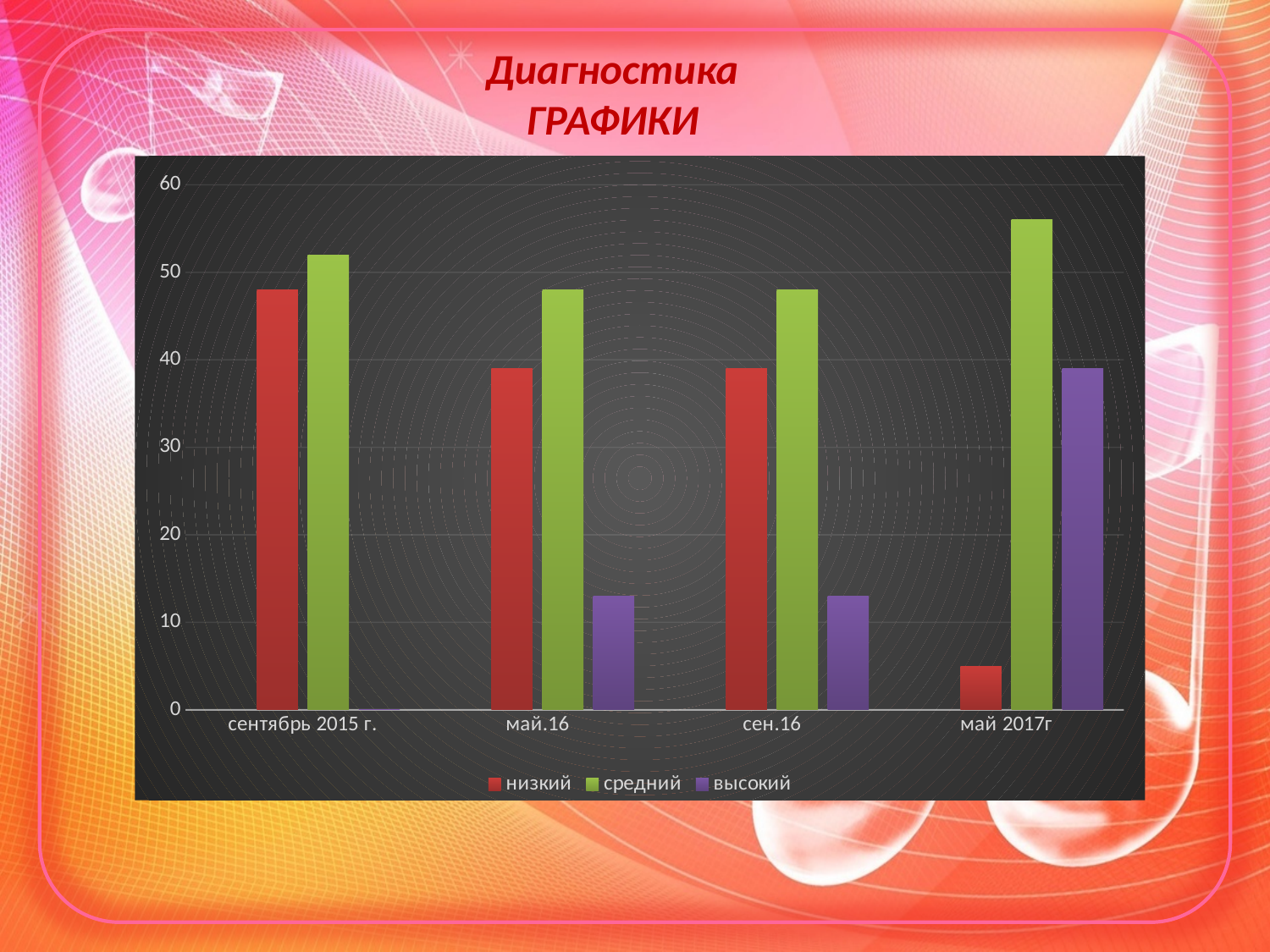
Is the value for низкий in сентябрь 2015 г. greater or less than 40? greater Is the value for низкий in май 2017г greater or less than 10? less Is the value for средний in май 2017г greater or less than 50? greater What kind of chart is shown on the slide? bar chart Does the высокий series rise or fall from сентябрь 2015 г. to май 2017г? rise In сен.16, which is larger: низкий or высокий? низкий How many series does the chart legend list? 3 Which category has the highest value for the средний series? май 2017г Which category has the lowest value for the низкий series? май 2017г How many categories are shown on the x axis of the chart? 4 In the сентябрь 2015 г. category, which series has the highest bar? средний